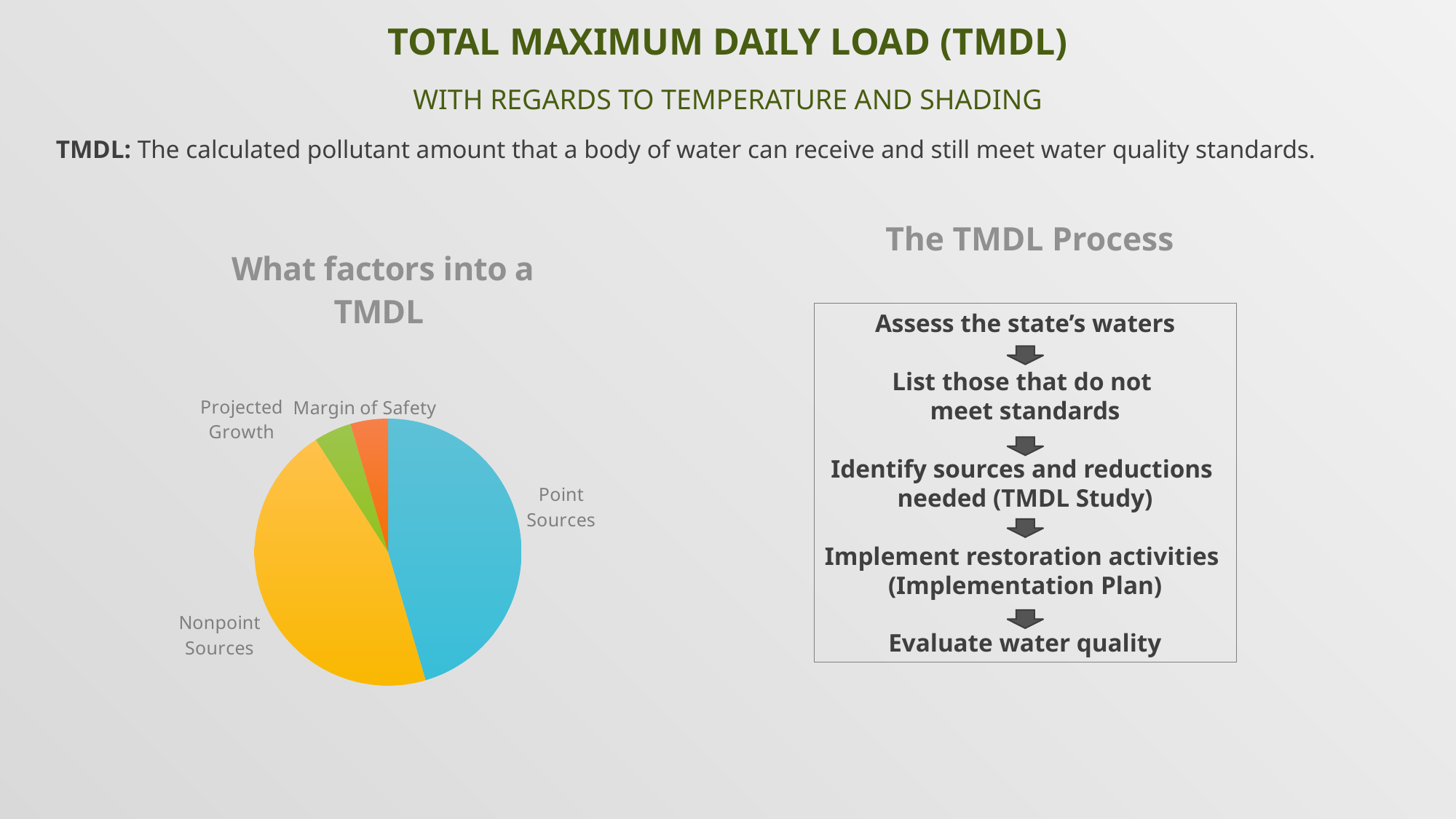
What colour is the Nonpoint Sources slice in the "What factors into a TMDL" pie chart? yellow What kind of chart is shown under the title "What factors into a TMDL"? pie chart In the "What factors into a TMDL" pie chart, which is larger: Point Sources or Margin of Safety? Point Sources What is the title of the pie chart on the slide? What factors into a TMDL In the "What factors into a TMDL" pie chart, which is larger: Nonpoint Sources or Projected Growth? Nonpoint Sources How many slices does the "What factors into a TMDL" pie chart have? 4